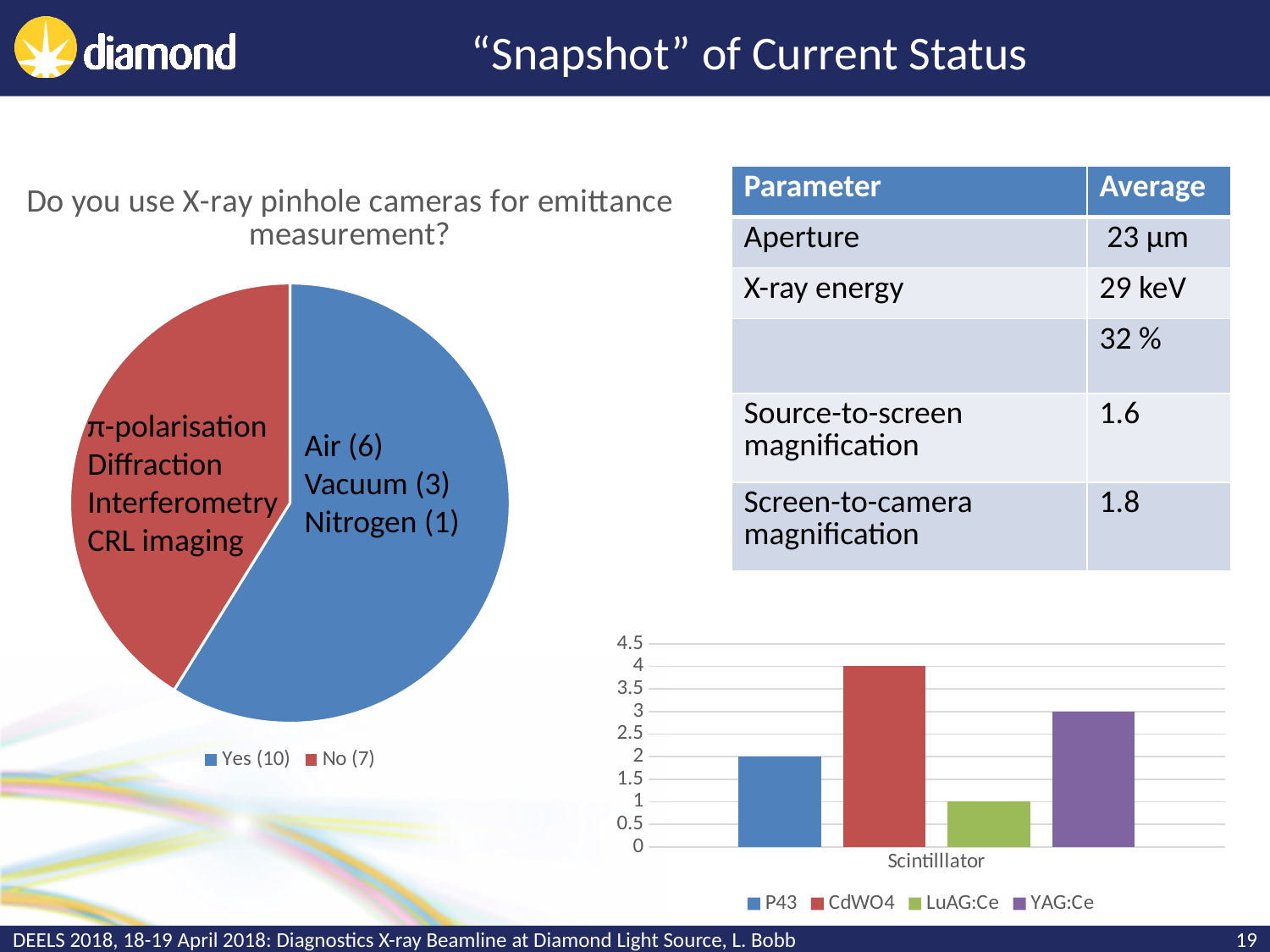
In the pie chart about X-ray pinhole cameras, how many entries does the legend list? 2 In the Scintilllator bar chart, what is the value for P43? 2 In the pie chart about X-ray pinhole cameras, how many respondents answered No? 7 In the Scintilllator bar chart, what is the value for CdWO4? 4 In the pie chart about X-ray pinhole cameras, which response has the larger slice, Yes or No? Yes In the Scintilllator bar chart, which series has the highest value? CdWO4 In the Scintilllator bar chart, how many series does the legend list? 4 What type of chart is the chart on the left of the slide? Pie chart In the Scintilllator bar chart, what is the difference between the values for YAG:Ce and LuAG:Ce? 2 In the pie chart about X-ray pinhole cameras, how many respondents answered Yes? 10 In the pie chart about X-ray pinhole cameras, what is the difference between the Yes count and the No count? 3 In the Scintilllator bar chart, which series has the lowest value? LuAG:Ce